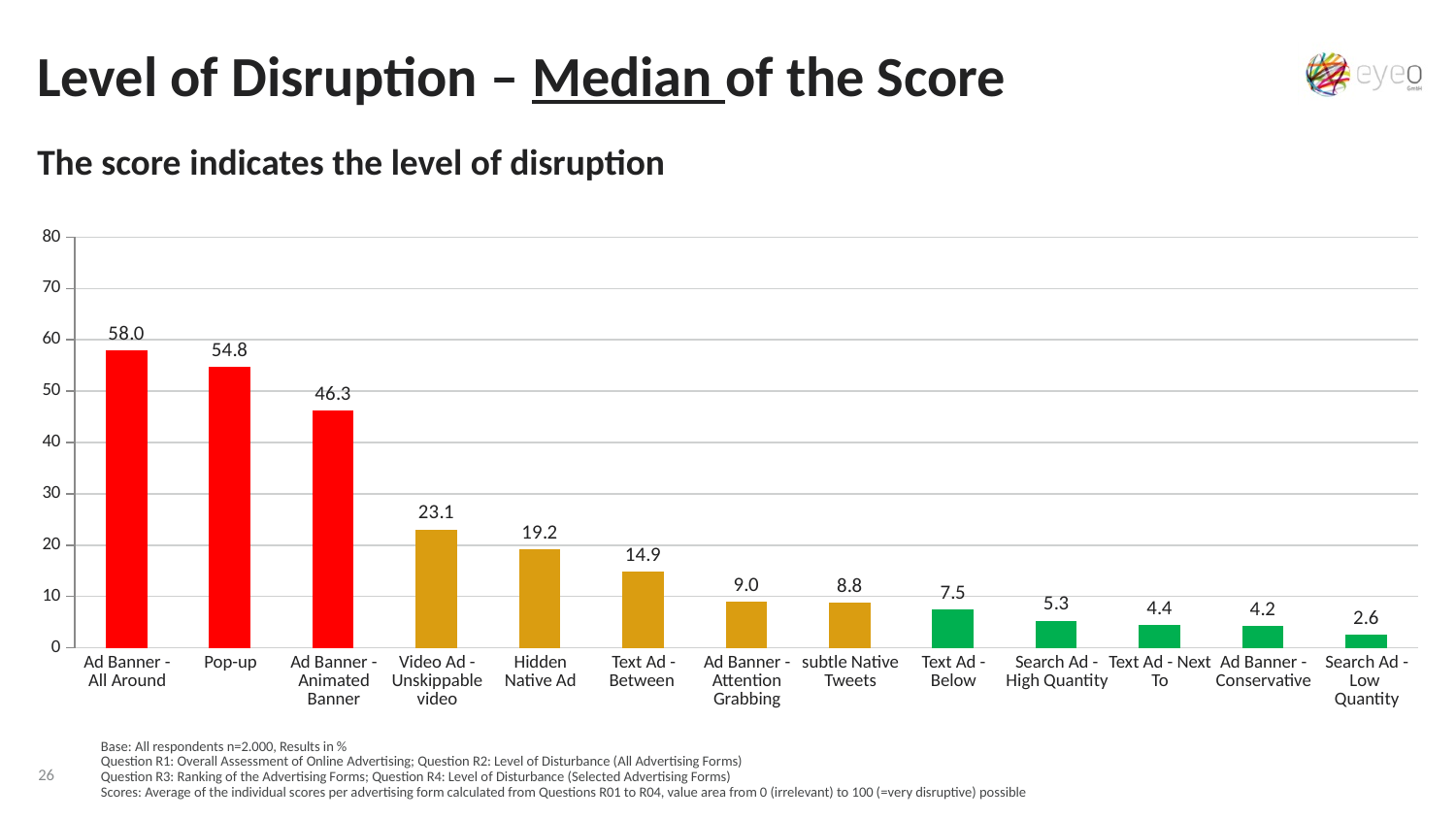
Which category has the highest value? Ad Banner - All Around What is the difference between the values for Video Ad - Unskippable video and Text Ad - Between? 8.2 What kind of chart is shown on the slide? bar chart What is the value for Search Ad - High Quantity? 5.3 What is the value for Hidden Native Ad? 19.2 Which is larger, the value for Text Ad - Below or the value for Text Ad - Next To? Text Ad - Below What is the value for Pop-up? 54.8 What is the difference between the values for Ad Banner - All Around and Ad Banner - Animated Banner? 11.7 Is the value for Ad Banner - Animated Banner greater or less than 40? greater Do the values rise or fall from left to right along the x axis? fall Which category has the lowest value? Search Ad - Low Quantity How many categories are shown on the x axis? 13